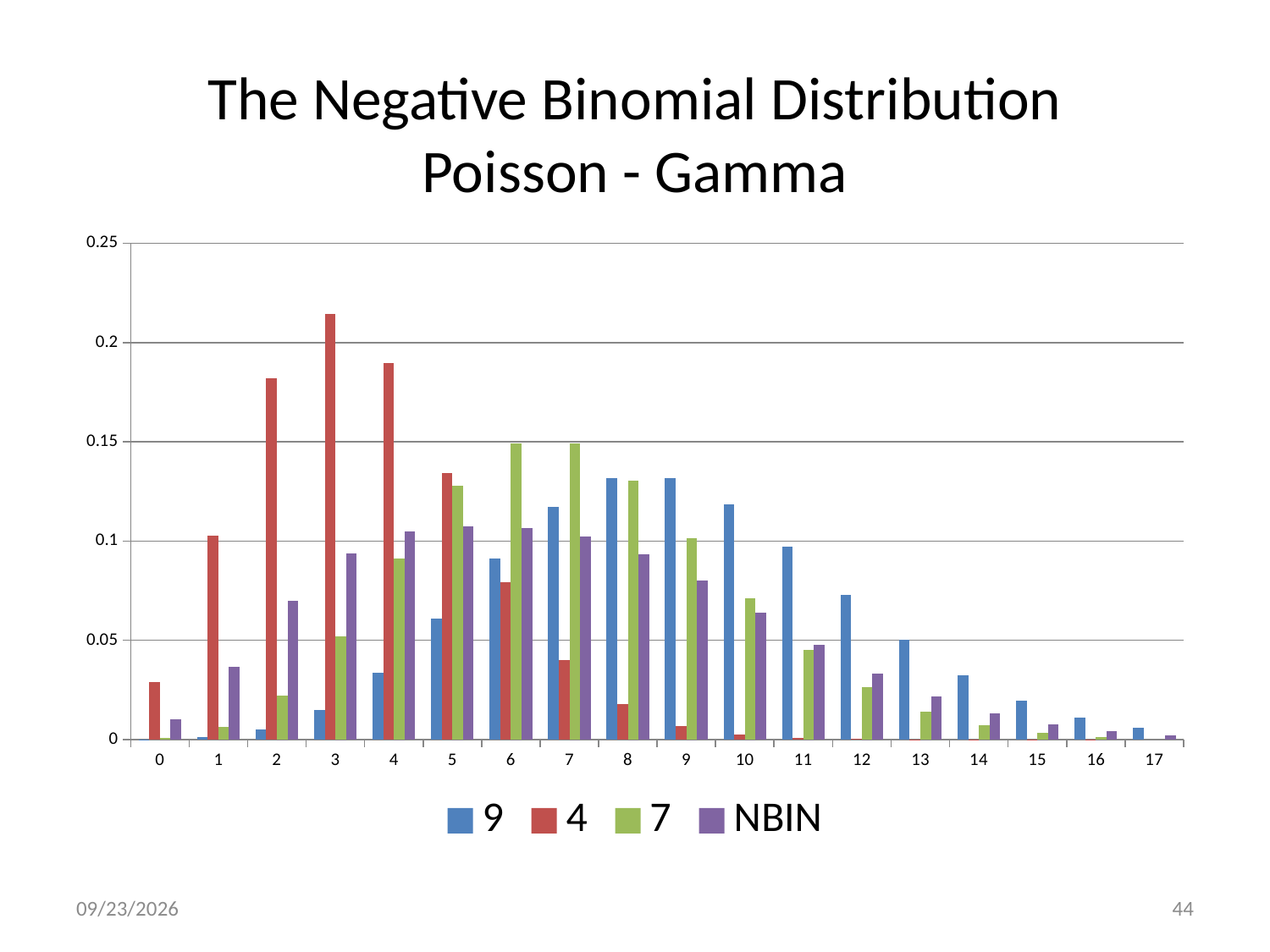
Do the values for series 4 rise or fall from category 3 to category 10? fall Is the value for series 7 at category 6 greater or less than 0.1? greater Is the value for series 4 at category 4 greater or less than 0.15? greater Is the value for series 4 at category 3 greater or less than 0.2? greater At category 2, which series has the larger value: 4 or NBIN? 4 At category 10, which series has the larger value: 9 or 7? 9 For the series labelled 4, at which x-axis category is the value highest? 3 What kind of chart is shown on the slide? bar chart How many series does the legend list? 4 What are the entries listed in the legend? 9, 4, 7, NBIN How many categories are shown along the x axis? 18